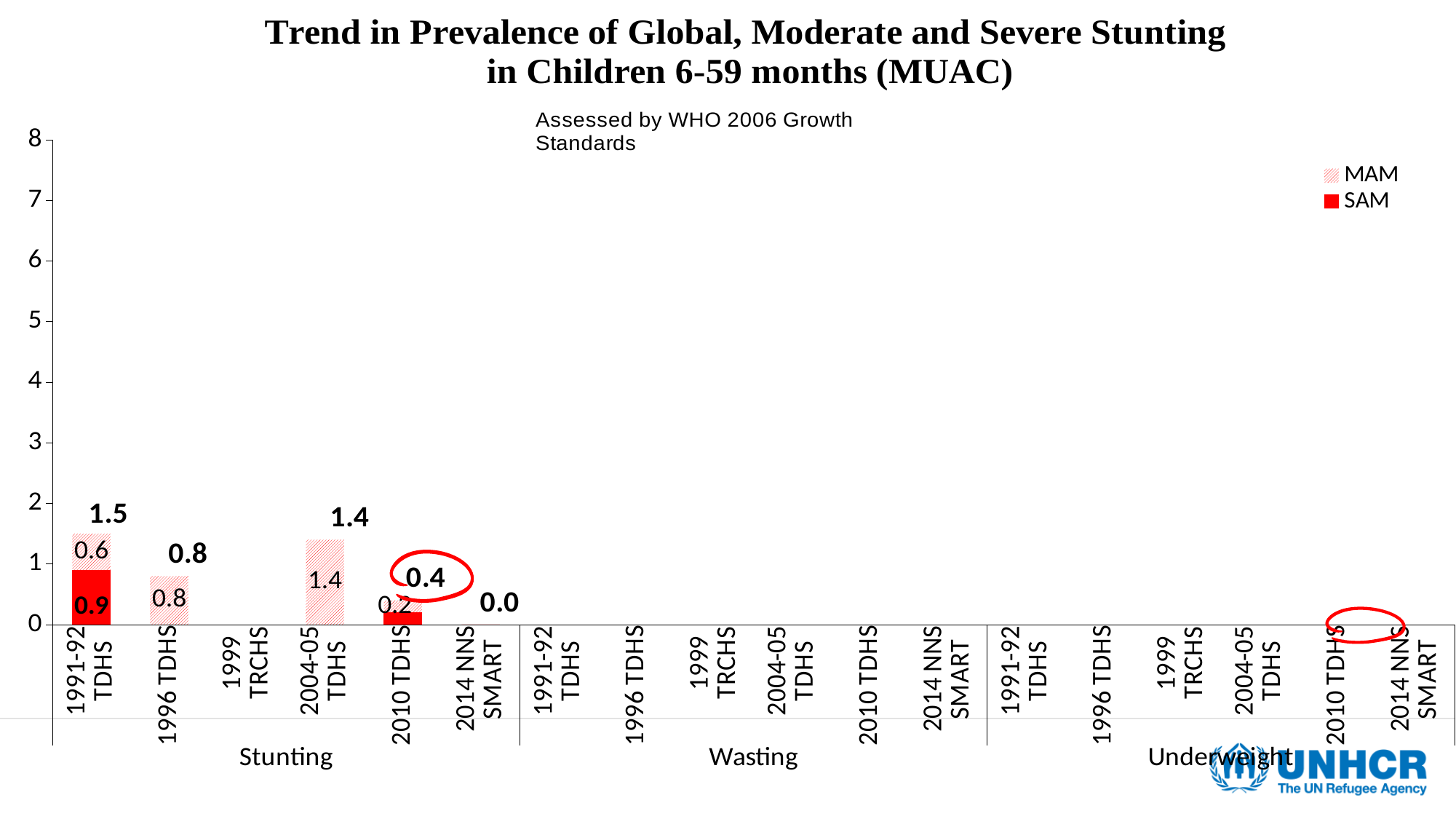
What is the MAM value for 2004-05 TDHS in the Stunting group? 1.4 What is the difference between the total for 1991-92 TDHS (1.5) and the total for 1996 TDHS (0.8) in the Stunting group? 0.7 What is the SAM value for 1991-92 TDHS in the Stunting group? 0.9 What is the SAM value for 2010 TDHS in the Stunting group? 0.2 How many series does the legend list? 2 Which survey in the Stunting group has the highest total bar? 1991-92 TDHS What are the two series named in the legend? MAM and SAM What is the value labelled for 2014 NNS SMART in the Stunting group? 0.0 What is the MAM value for 1991-92 TDHS in the Stunting group? 0.6 What type of chart is shown on the slide? bar chart What is the total value labelled for 2010 TDHS in the Stunting group? 0.4 What is the total of the stacked bar for 1991-92 TDHS in the Stunting group? 1.5